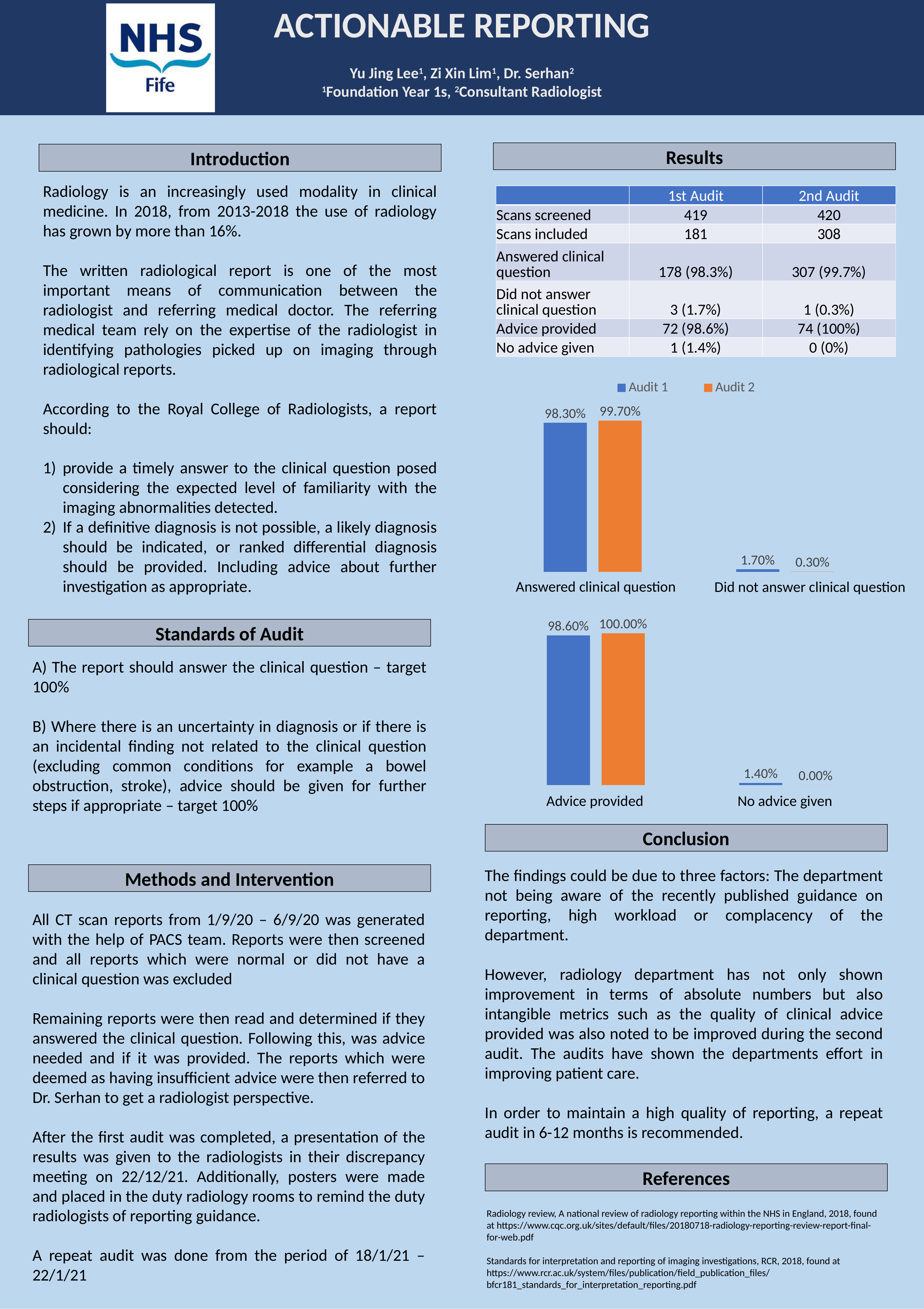
In the lower chart, what is the Audit 2 value for Advice provided? 100.00% In the upper chart, which audit has the larger value for Did not answer clinical question? Audit 1 In the lower chart, which category has the lowest value across both audits? No advice given In the upper chart, what is the Audit 2 value for Did not answer clinical question? 0.30% In the lower chart, which audit has the larger value for Advice provided? Audit 2 In the upper chart, what is the Audit 1 value for Answered clinical question? 98.30% In the lower chart, what is the Audit 1 value for No advice given? 1.40% What colour represents Audit 2 in the charts? Orange How many series does the legend above the charts list? 2 In the upper chart, what is the difference between the Audit 2 and Audit 1 values for Answered clinical question? 1.40% In the lower chart, what is the difference between the Audit 1 and Audit 2 values for No advice given? 1.40% What type of chart is the upper chart? Bar chart